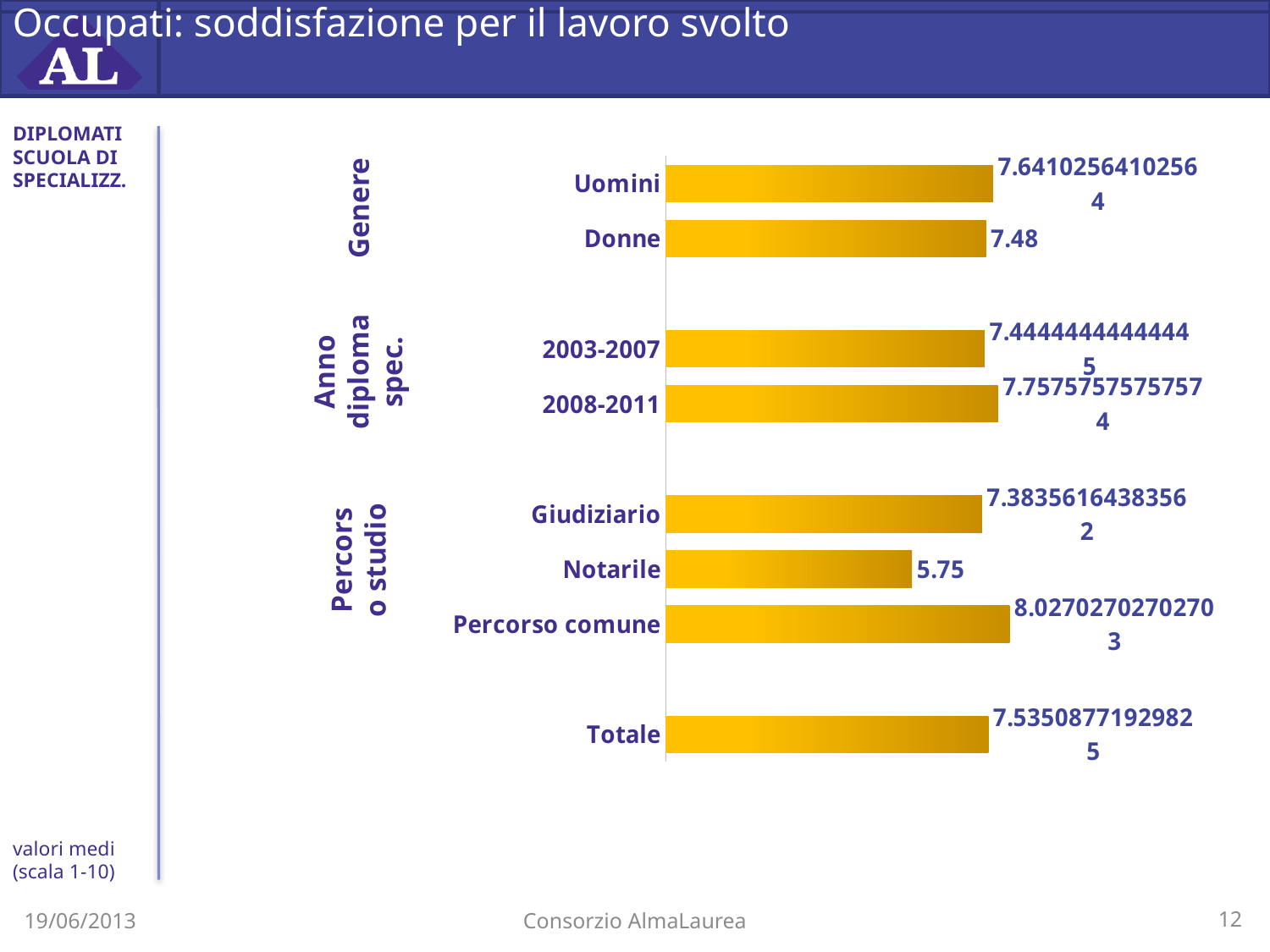
What is the difference between the values for Donne and Notarile? 1.73 What is the value for Uomini? 7.64102564102564 What kind of chart is shown on the slide? Bar chart What is the value for Donne? 7.48 Which category has the lowest value? Notarile Which category has the highest value? Percorso comune What is the value for Percorso comune? 8.02702702702703 What is the value for Totale? 7.53508771929825 What is the value for Notarile? 5.75 Which has the larger value, Uomini or Donne? Uomini Which has the larger value, 2003-2007 or 2008-2011? 2008-2011 How many bars are plotted in the chart? 8